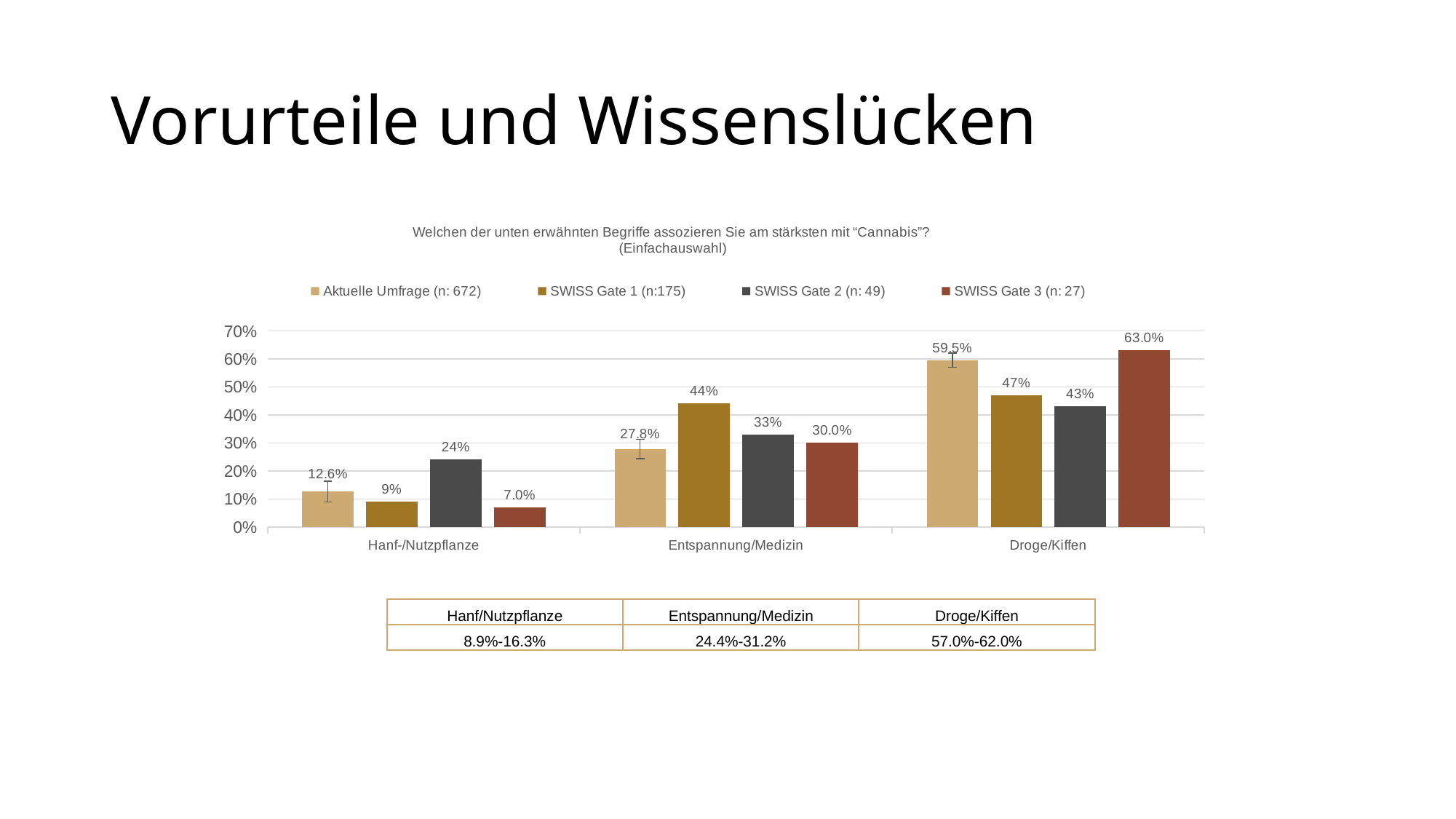
Is the value for SWISS Gate 1 (n:175) in the Droge/Kiffen category greater or less than 40%? greater What is the value for Aktuelle Umfrage (n: 672) in the Droge/Kiffen category? 59.5% Which series has the lowest value in the Hanf-/Nutzpflanze category? SWISS Gate 3 (n: 27) How many series does the legend list? 4 What kind of chart is shown on the slide? Bar chart Which is larger in the Hanf-/Nutzpflanze category: Aktuelle Umfrage (n: 672) or SWISS Gate 2 (n: 49)? SWISS Gate 2 (n: 49) What is the difference between SWISS Gate 1 (n:175) and SWISS Gate 2 (n: 49) in the Entspannung/Medizin category? 11 percentage points Which series has the highest value in the Droge/Kiffen category? SWISS Gate 3 (n: 27) What is the value for SWISS Gate 2 (n: 49) in the Droge/Kiffen category? 43% How many categories are shown on the x axis? 3 What is the value for SWISS Gate 3 (n: 27) in the Hanf-/Nutzpflanze category? 7.0% What is the value for SWISS Gate 1 (n:175) in the Entspannung/Medizin category? 44%